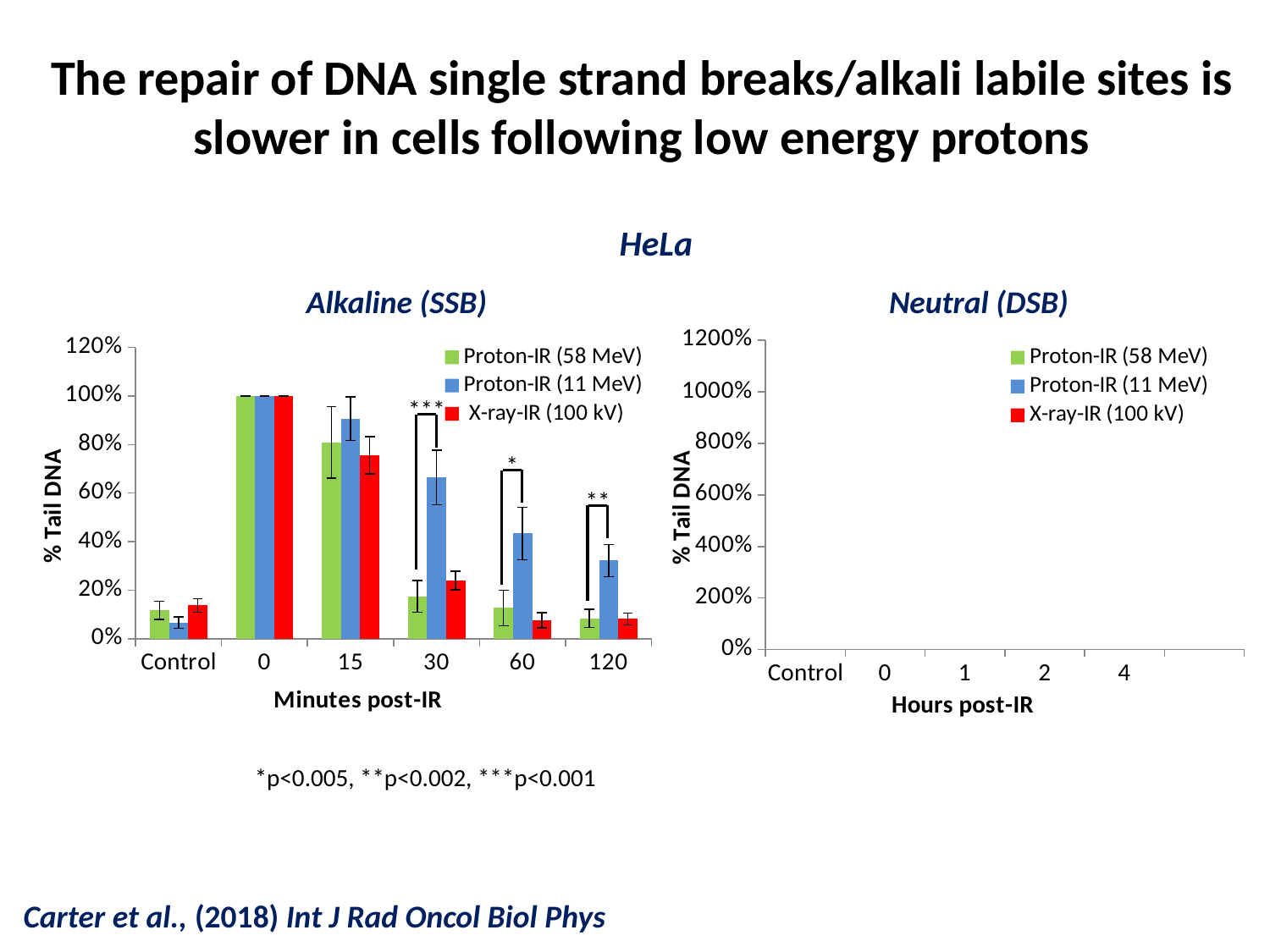
In the Alkaline (SSB) chart, is the value for Proton-IR (11 MeV) at 30 minutes greater or less than 60%? greater In the Alkaline (SSB) chart, is the value for Proton-IR (58 MeV) at 60 minutes greater or less than 20%? less In the Alkaline (SSB) chart, is the value for Proton-IR (11 MeV) at 120 minutes greater or less than 20%? greater How many series does the legend of the Alkaline (SSB) chart list? 3 What is the y-axis title of the Alkaline (SSB) chart? % Tail DNA In the Alkaline (SSB) chart, do the Proton-IR (11 MeV) values rise or fall from 0 to 120 minutes post-IR? fall In the Alkaline (SSB) chart, what is the value for Proton-IR (11 MeV) at 0 minutes post-IR? 100% What is the x-axis title of the Neutral (DSB) chart? Hours post-IR In the Alkaline (SSB) chart, which series has the highest value at 60 minutes post-IR? Proton-IR (11 MeV) In the Alkaline (SSB) chart, at 30 minutes post-IR, which is larger: Proton-IR (11 MeV) or X-ray-IR (100 kV)? Proton-IR (11 MeV) What kind of chart is the Alkaline (SSB) chart? bar chart How many categories are shown on the x axis of the Alkaline (SSB) chart? 6